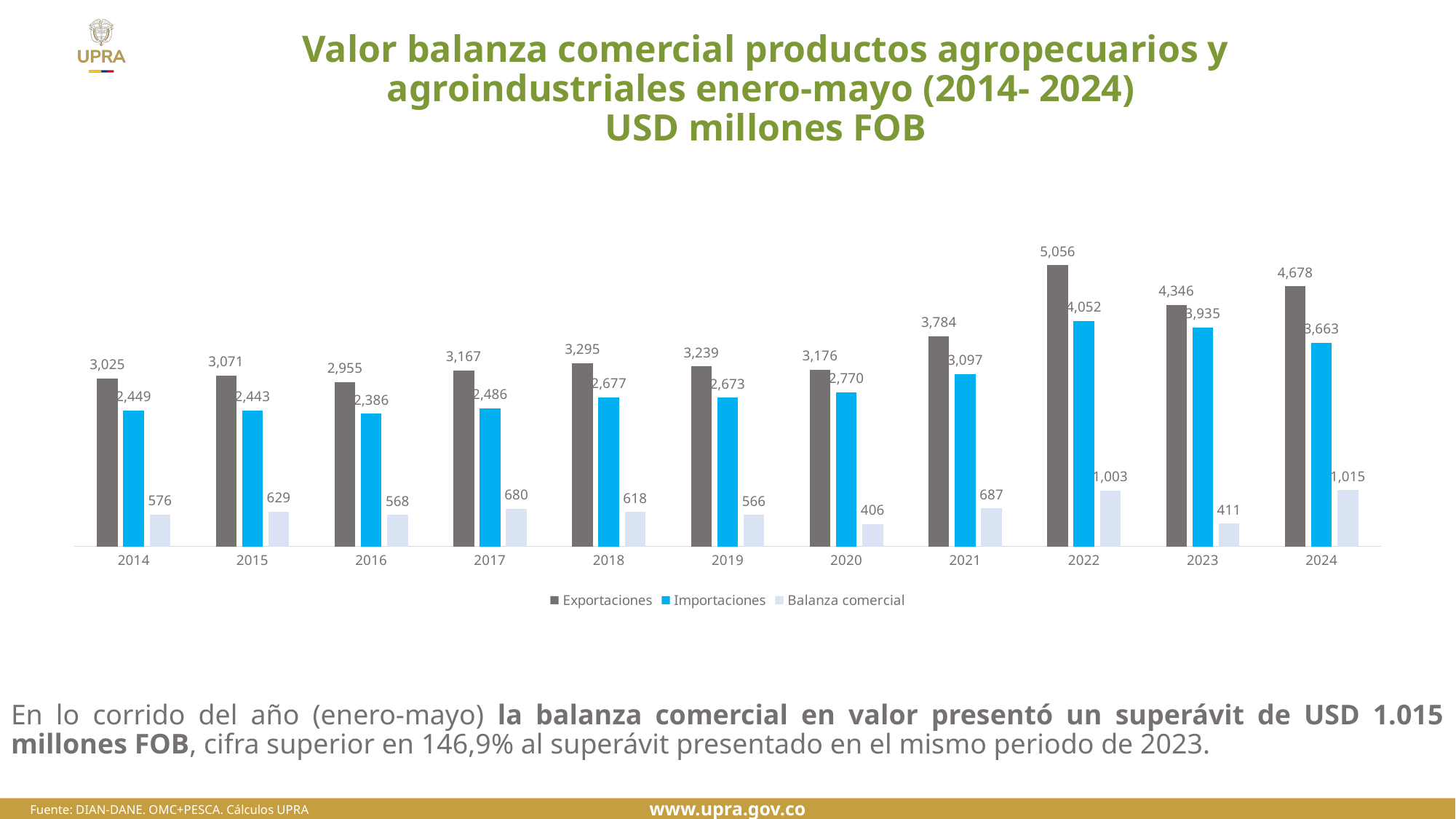
What colour are the Importaciones bars? Blue What kind of chart is shown on the slide? Bar chart What is the value of Exportaciones for 2022? 5,056 Which is larger, Importaciones in 2021 or Importaciones in 2019? Importaciones in 2021 Do the Importaciones values rise or fall from 2020 to 2022? Rise What is the value of Importaciones for 2016? 2,386 What is the difference between Exportaciones and Importaciones in 2024? 1,015 How many series does the legend list? 3 In which year is Balanza comercial lowest? 2020 How many years are shown on the x axis? 11 What is the value of Balanza comercial for 2020? 406 In which year is Exportaciones highest? 2022